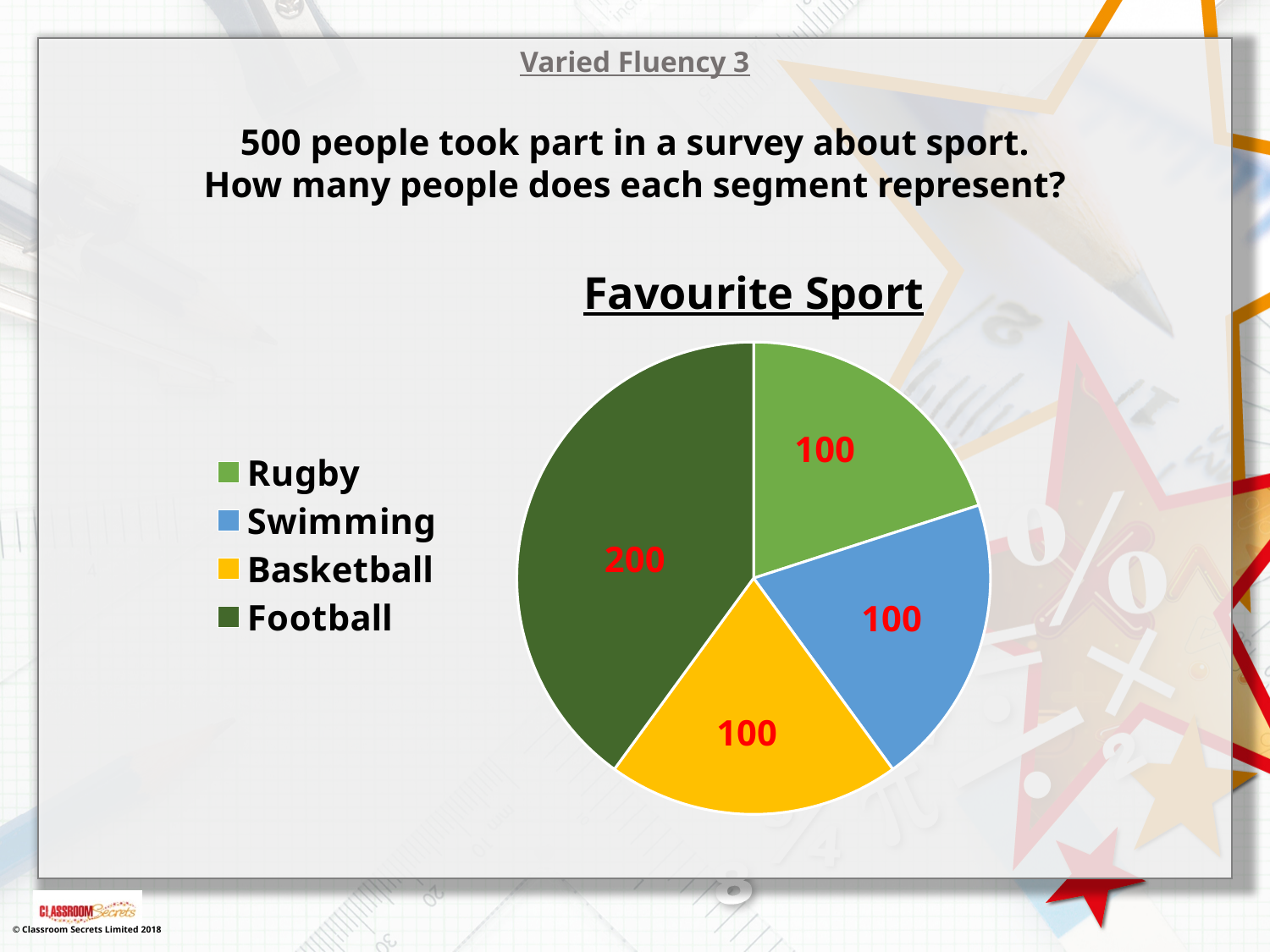
What value is shown for the Rugby segment? 100 What is the difference between the Football value and the Basketball value? 100 What colour is the Basketball segment? yellow What share of the pie does the Football segment represent? 40% What kind of chart is shown on the slide? pie chart Which sport has the largest segment in the pie chart? Football What value is shown for the Football segment? 200 How many segments does the pie chart have? 4 Which is larger, the Football segment or the Swimming segment? Football How many entries does the legend list? 4 What is the title of the chart? Favourite Sport What value is shown for the Swimming segment? 100